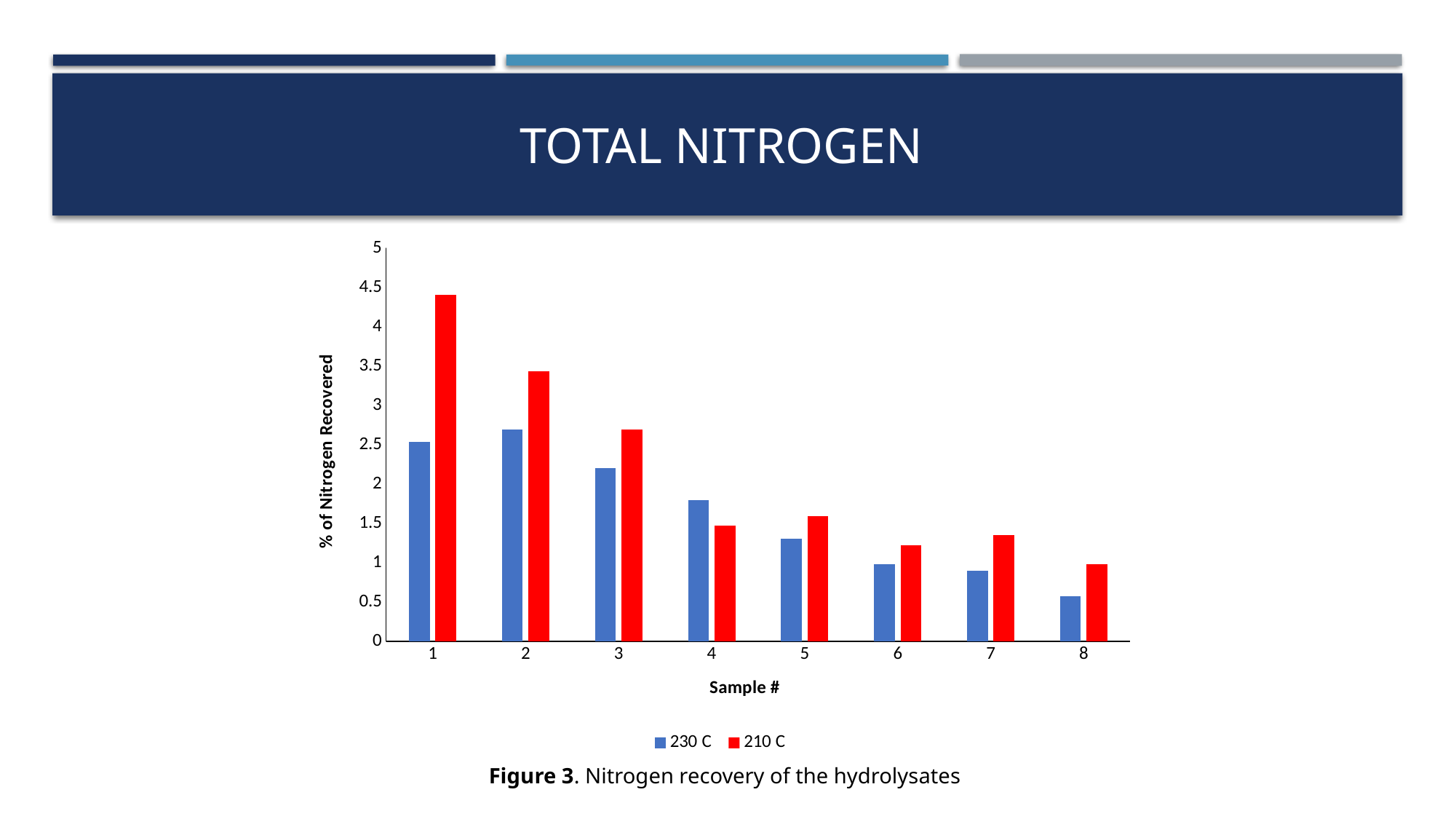
Do the values for the 230 C series generally rise or fall from sample 1 to sample 8? Fall Is the value for sample 1 in the 210 C series greater or less than 4? greater How many samples are shown on the x axis? 8 How many series does the legend list? 2 Is the value for sample 8 in the 230 C series greater or less than 1? less Which sample has the highest value for the 210 C series? Sample 1 What kind of chart is shown on the slide? Bar chart For sample 4, which series has the larger value, 230 C or 210 C? 230 C Which sample has the lowest value for the 210 C series? Sample 8 Is the value for sample 2 in the 210 C series greater or less than 3? greater Which sample has the lowest value for the 230 C series? Sample 8 For sample 1, which series has the larger value, 230 C or 210 C? 210 C